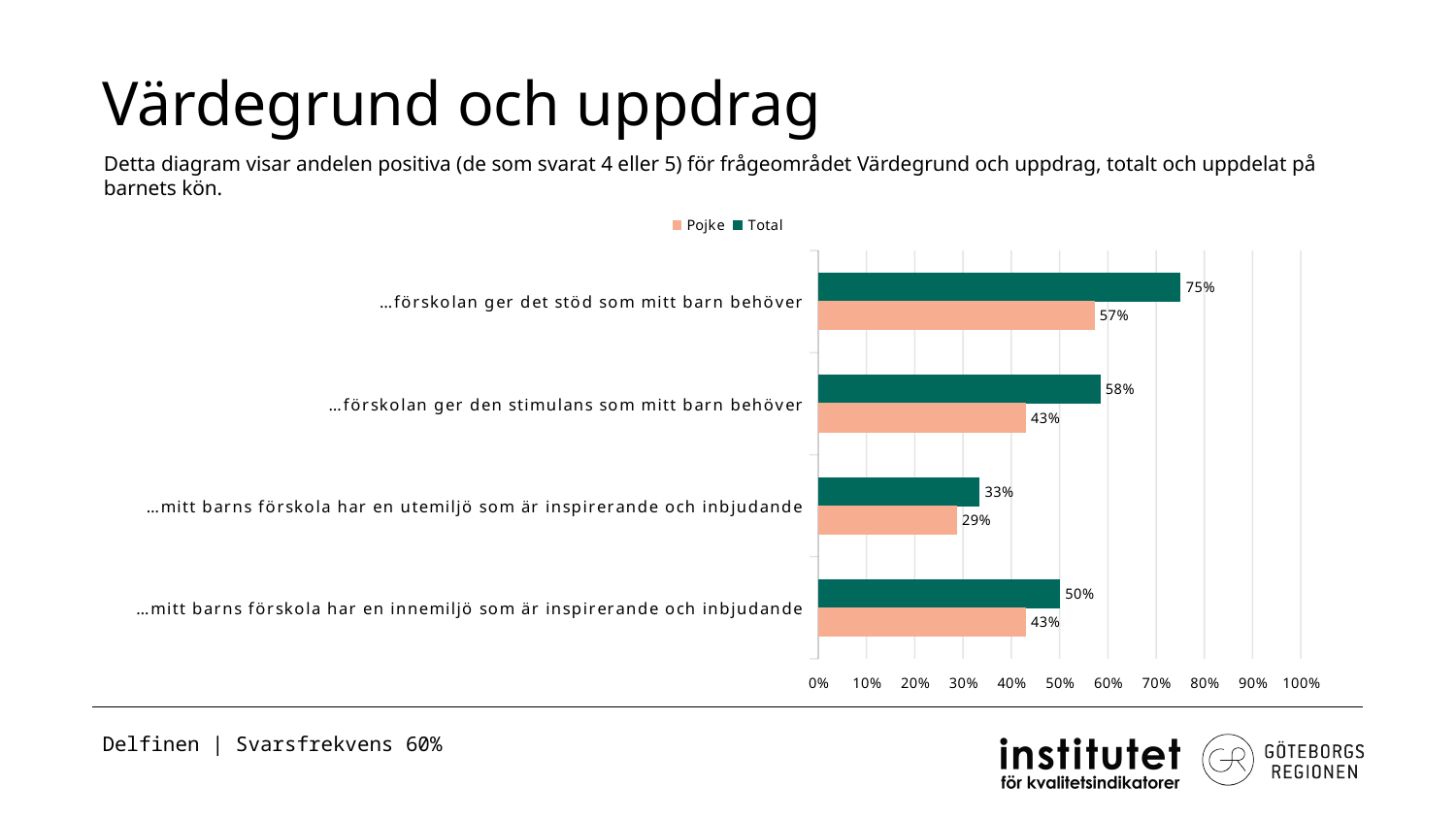
What is the Pojke value for "…förskolan ger den stimulans som mitt barn behöver"? 43% What is the Total value for "…förskolan ger det stöd som mitt barn behöver"? 75% What is the Pojke value for "…mitt barns förskola har en utemiljö som är inspirerande och inbjudande"? 29% Which category has the lowest Pojke value? …mitt barns förskola har en utemiljö som är inspirerande och inbjudande Which is larger for "…mitt barns förskola har en innemiljö som är inspirerande och inbjudande": the Total value or the Pojke value? Total What is the Total value for "…mitt barns förskola har en innemiljö som är inspirerande och inbjudande"? 50% Which series is shown in green in the chart? Total What kind of chart is shown on the slide? Bar chart How many categories are shown in the chart? 4 Which category has the highest Total value? …förskolan ger det stöd som mitt barn behöver What is the difference between the Total and Pojke values for "…förskolan ger det stöd som mitt barn behöver"? 18 percentage points How many series does the legend list? 2